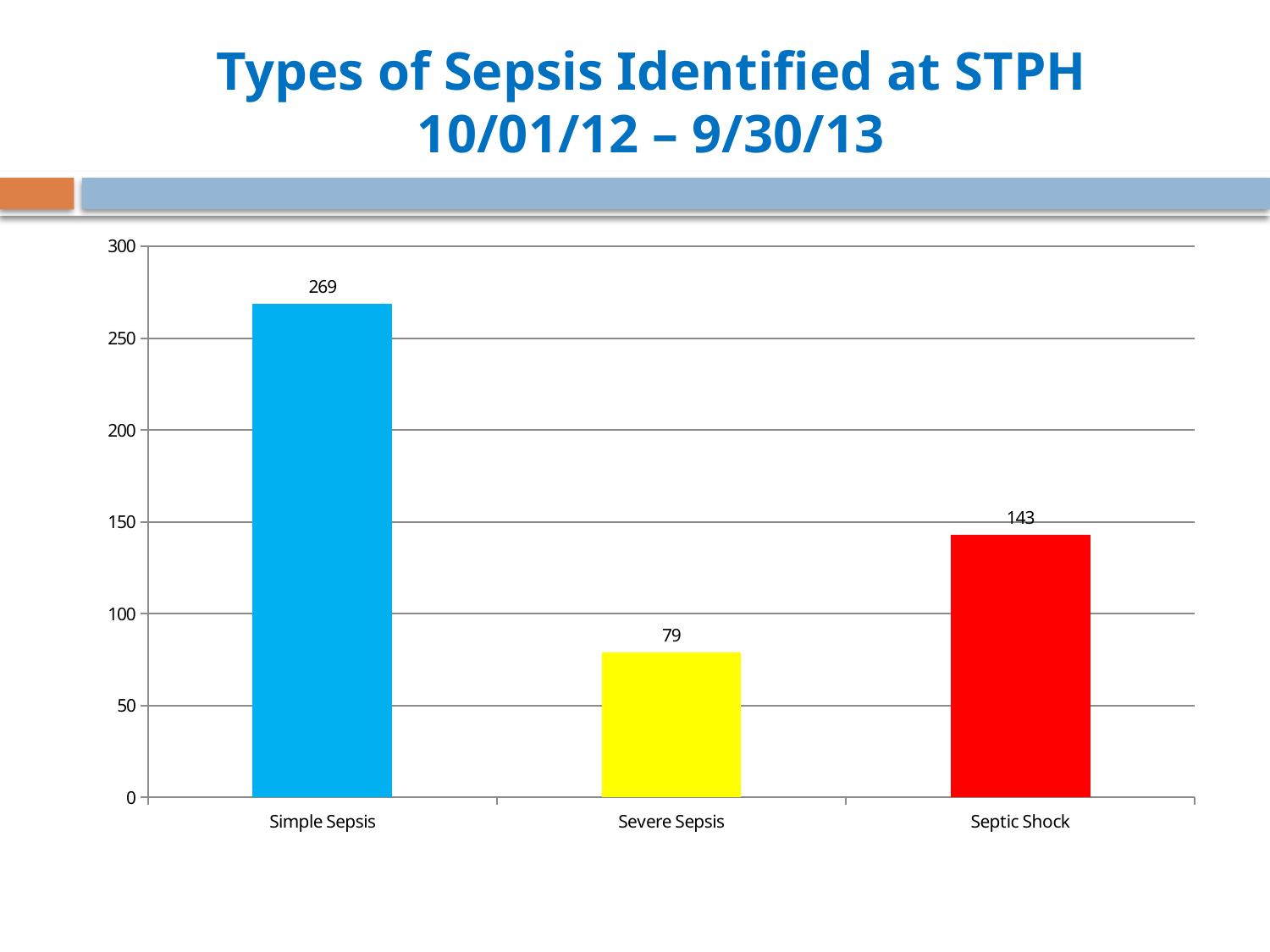
What is the difference between the values for Simple Sepsis and Septic Shock? 126 Is the value for Simple Sepsis greater or less than 250? greater What is the value for Severe Sepsis? 79 Which category has the highest value? Simple Sepsis What kind of chart is shown on the slide? bar chart How many categories are shown on the chart? 3 What colour is the bar for Severe Sepsis? yellow What is the value for Simple Sepsis? 269 What is the value for Septic Shock? 143 What is the difference between the values for Septic Shock and Severe Sepsis? 64 Which category has the lowest value? Severe Sepsis Which is larger, the value for Septic Shock or the value for Severe Sepsis? Septic Shock